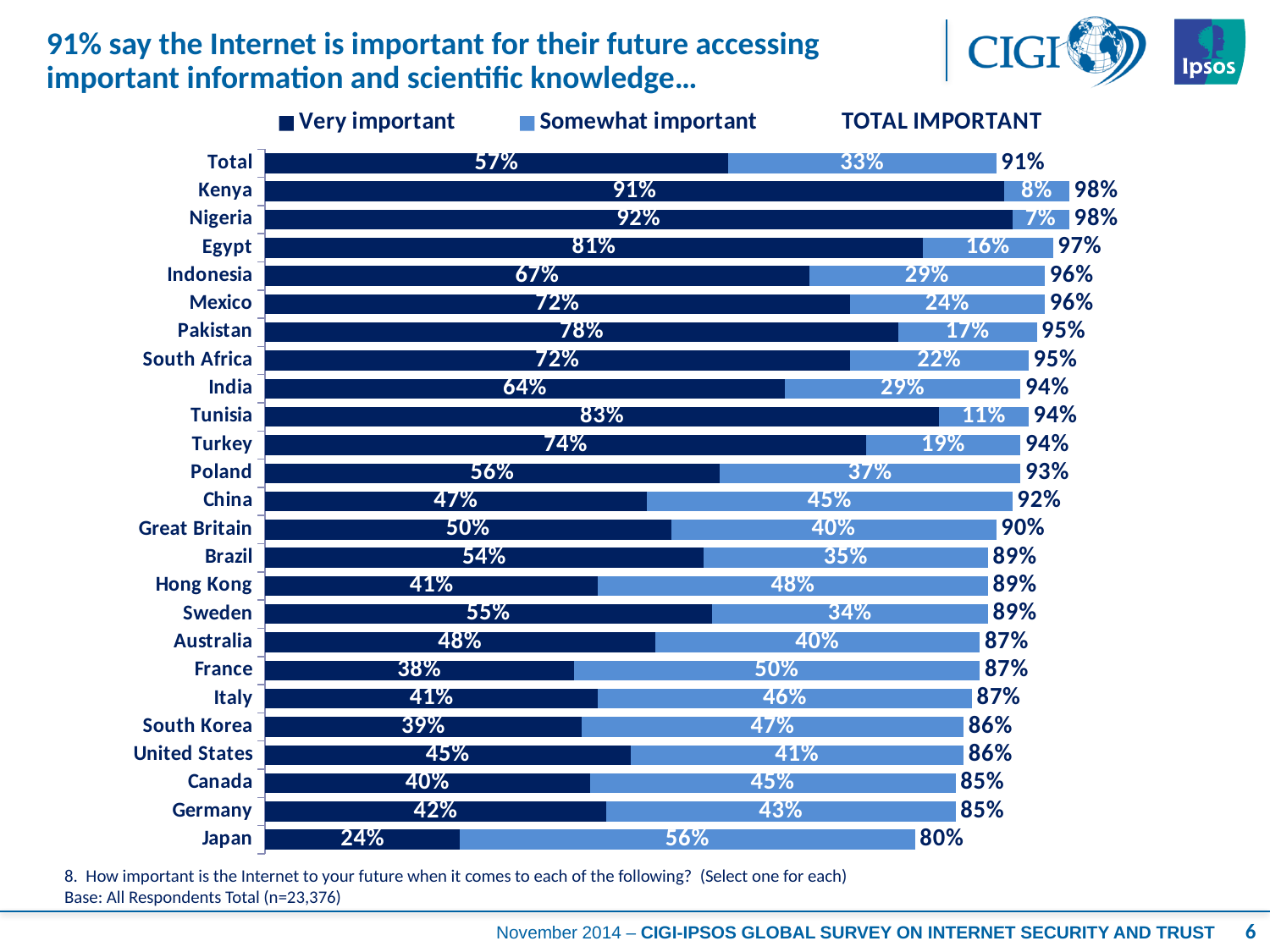
What percentage of respondents in Kenya say the Internet is "Very important"? 91% How many series does the legend list? 2 What are the two legend entries in the chart? Very important; Somewhat important Which country has the lowest TOTAL IMPORTANT value? Japan What is the total of the stacked bar for Hong Kong (Very important plus Somewhat important)? 89% How many bars (categories) are shown in the chart, including Total? 25 What is the "Somewhat important" value for Japan? 56% What is the TOTAL IMPORTANT value for Egypt? 97% Which country has the highest "Very important" percentage? Nigeria What is the difference between the "Very important" values for Tunisia and Poland? 27 percentage points What kind of chart is shown on the slide? Stacked bar chart Which has a larger "Somewhat important" value, France or Germany? France